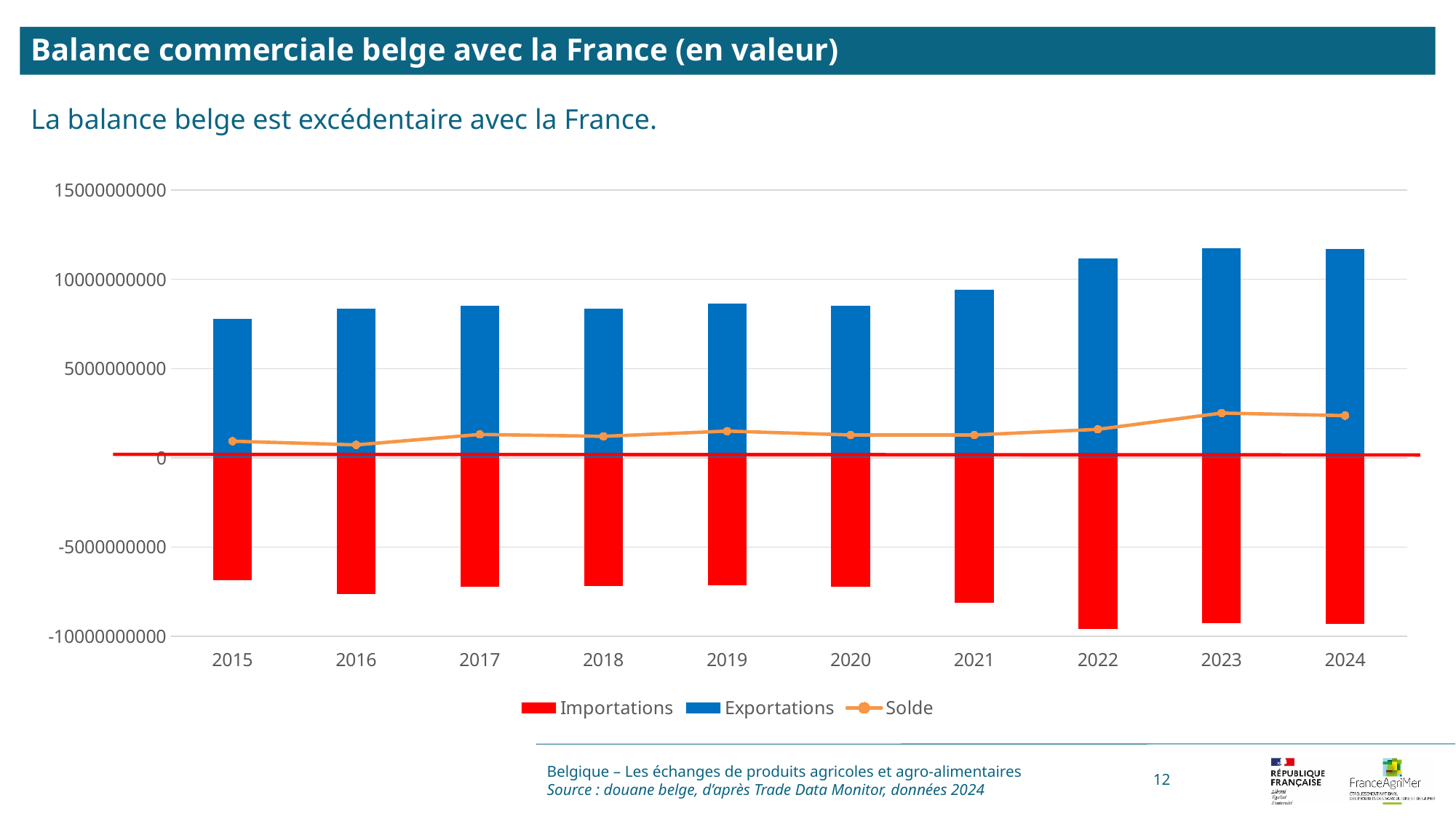
Is the Importations value for 2022 greater or less than -5000000000? less How many years are shown on the x axis of the chart? 10 Is the Exportations value for 2015 greater or less than 10000000000? less What colour represents Importations in the chart? red Which is larger, the Exportations value for 2021 or for 2022? 2022 How many series does the chart legend list? 3 Which year has the lowest Exportations value? 2015 Is the Exportations value for 2022 greater or less than 10000000000? greater What kind of chart is shown on the slide? bar chart with a line Do the Exportations values generally rise or fall from 2015 to 2024? rise Which is larger, the Solde value for 2016 or for 2023? 2023